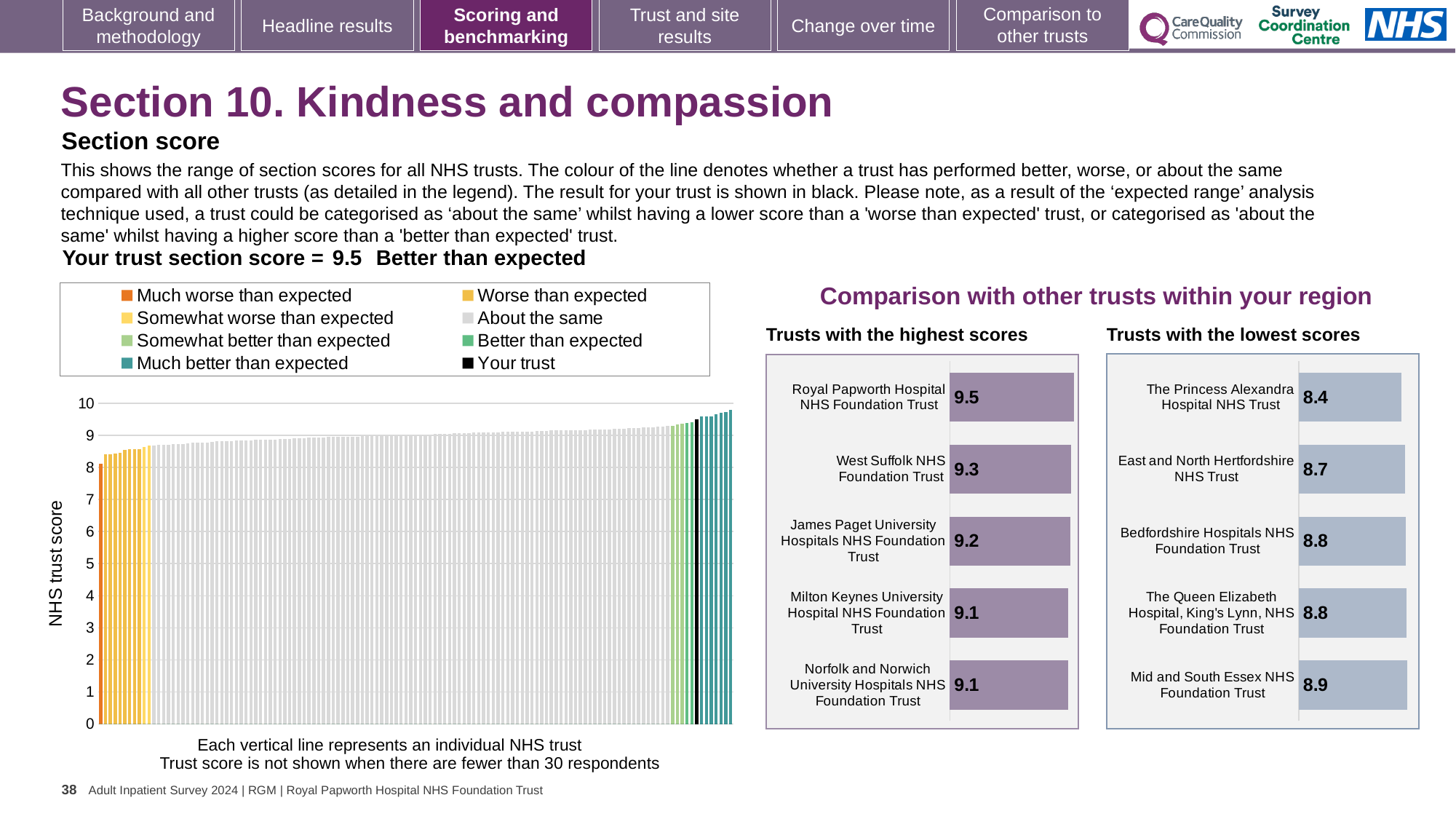
In the 'Trusts with the highest scores' chart, what is the score for West Suffolk NHS Foundation Trust? 9.3 In the 'Trusts with the highest scores' chart, what is the difference between the scores of Royal Papworth Hospital NHS Foundation Trust and James Paget University Hospitals NHS Foundation Trust? 0.3 In the 'Trusts with the lowest scores' chart, which trust has the lowest score? The Princess Alexandra Hospital NHS Trust In the 'Trusts with the lowest scores' chart, which has the larger score: East and North Hertfordshire NHS Trust or Mid and South Essex NHS Foundation Trust? Mid and South Essex NHS Foundation Trust What kind of chart is the 'Trusts with the lowest scores' chart? Bar chart In the NHS trust score chart on the left, do the bar values rise or fall from left to right? rise In the NHS trust score chart on the left, what is the section score for your trust? 9.5 In the 'Trusts with the lowest scores' chart, what is the difference between the scores of Mid and South Essex NHS Foundation Trust and The Princess Alexandra Hospital NHS Trust? 0.5 In the 'Trusts with the lowest scores' chart, what is the score for The Princess Alexandra Hospital NHS Trust? 8.4 In the NHS trust score chart on the left, is the value for your trust (the black bar) greater or less than 9? greater In the 'Trusts with the highest scores' chart, which trust has the highest score? Royal Papworth Hospital NHS Foundation Trust In the 'Trusts with the highest scores' chart, how many trusts are listed? 5